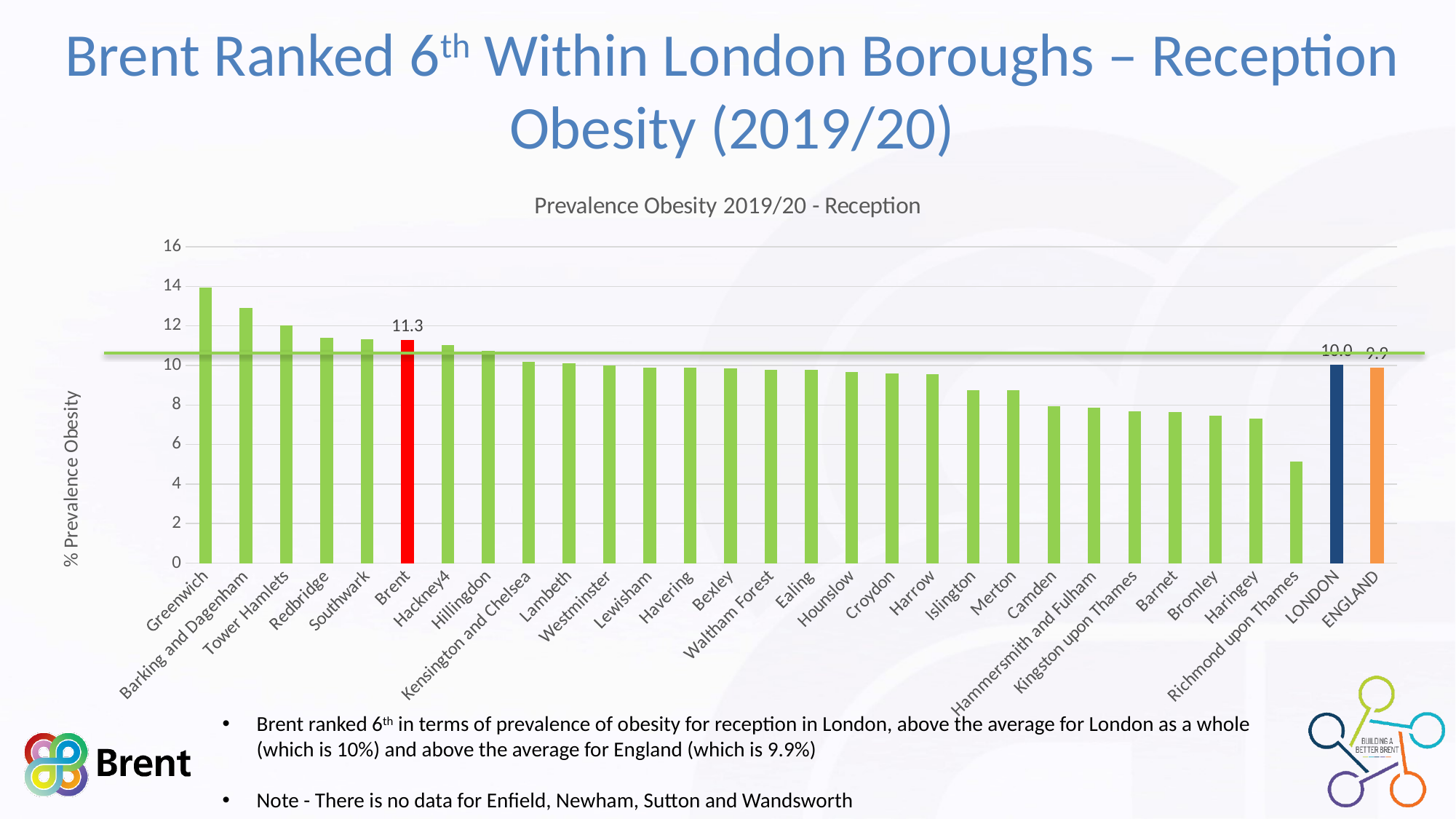
What is the difference between the Brent value and the ENGLAND value? 1.4 Which is larger, the value for Greenwich or the value for Barking and Dagenham? Greenwich What is the value for ENGLAND in the chart? 9.9 What is the label on the vertical axis of the chart? % Prevalence Obesity Which borough has the lowest prevalence of obesity in the chart? Richmond upon Thames What kind of chart is shown on the slide? bar chart What is the value for Brent in the Prevalence Obesity 2019/20 - Reception chart? 11.3 Is the value for Barking and Dagenham greater or less than 12? greater Is the value for Richmond upon Thames greater or less than 6? less What is the value for LONDON in the chart? 10.0 What is the difference between the Brent value and the LONDON value? 1.3 Which borough has the highest prevalence of obesity in the chart? Greenwich